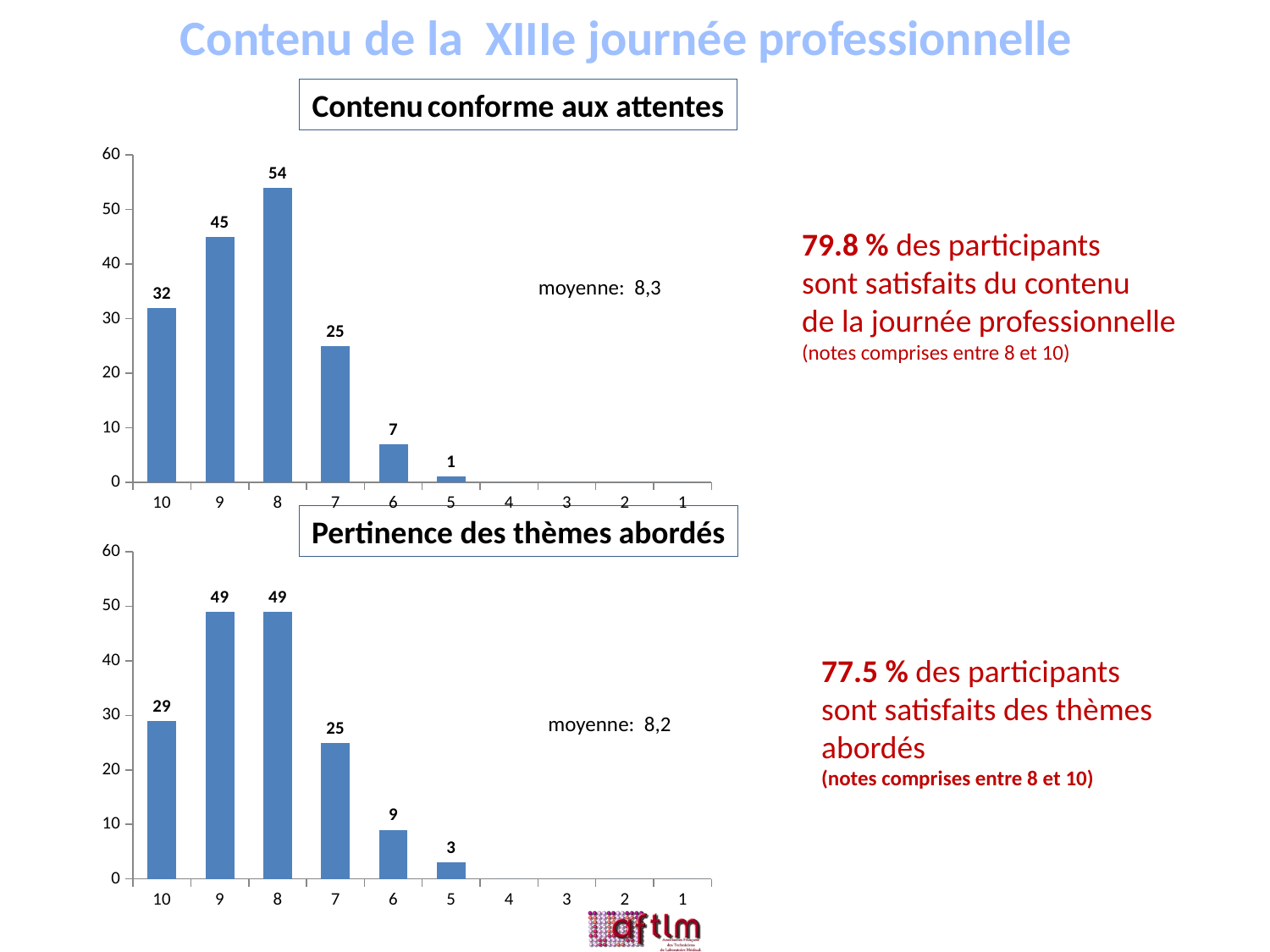
In the 'Pertinence des thèmes abordés' chart, what is the value for the score 10? 29 How many score categories are shown on the x axis of the 'Pertinence des thèmes abordés' chart? 10 In the 'Contenu conforme aux attentes' chart, is the value for score 9 greater or less than 40? greater In the 'Pertinence des thèmes abordés' chart, what is the value for the score 6? 9 In the 'Contenu conforme aux attentes' chart, what is the value for the score 10? 32 In the 'Pertinence des thèmes abordés' chart, what is the difference between the values for scores 9 and 10? 20 In the 'Pertinence des thèmes abordés' chart, which is larger, the value for score 10 or the value for score 7? score 10 In the 'Contenu conforme aux attentes' chart, what is the value for the score 8? 54 What type of chart is the 'Contenu conforme aux attentes' chart? bar chart What average (moyenne) is shown on the 'Pertinence des thèmes abordés' chart? 8,2 In the 'Contenu conforme aux attentes' chart, which score has the highest value? 8 In the 'Contenu conforme aux attentes' chart, what is the difference between the values for scores 9 and 7? 20